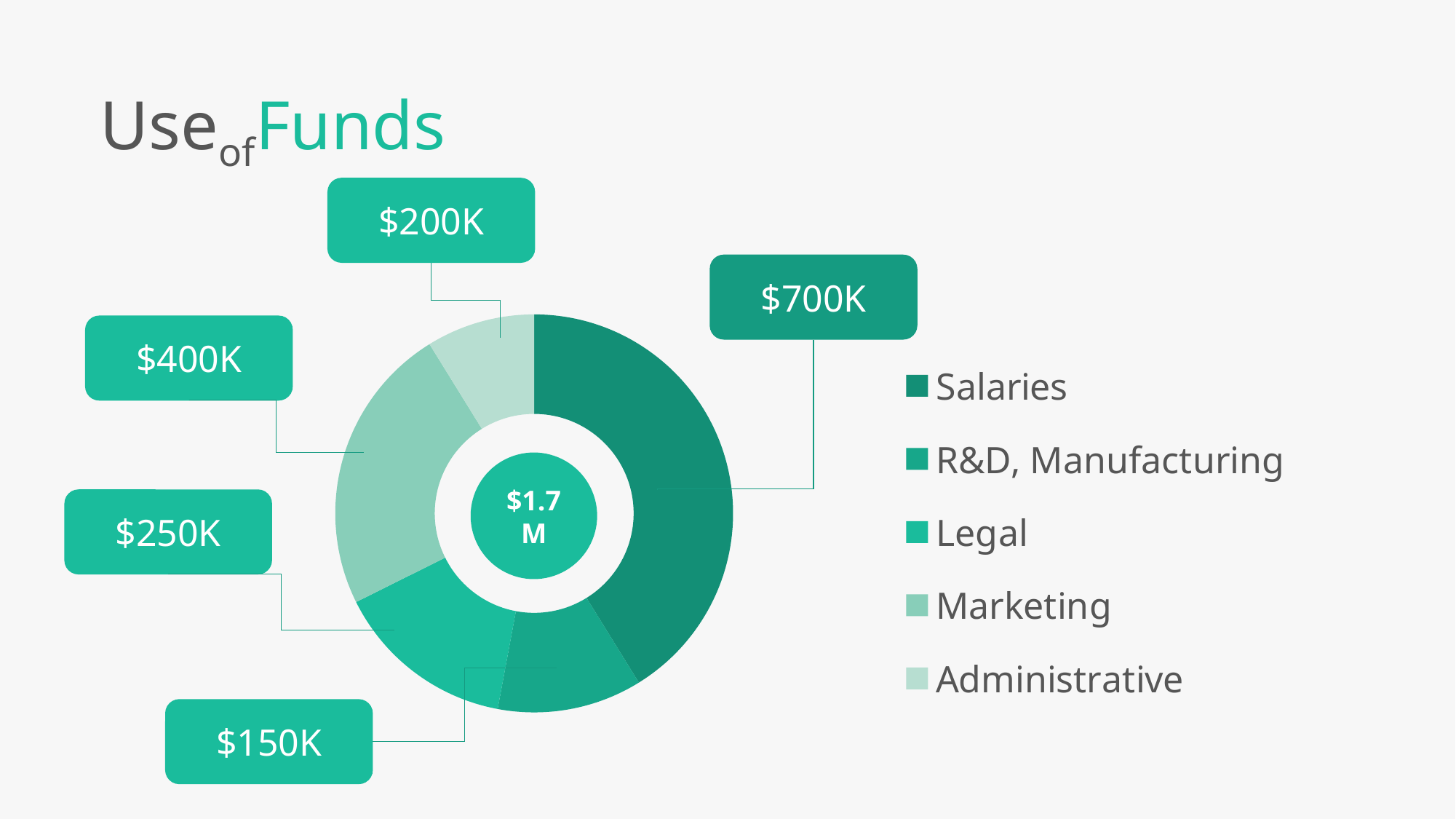
What value is shown for Salaries? $700K Which category receives the largest amount of funds? Salaries What kind of chart is shown on the slide? Pie (donut) chart Which is larger, the amount for Legal or the amount for Administrative? Legal How many categories are shown in the chart? 5 What is the title of the slide? Use of Funds What total amount is shown in the centre of the chart? $1.7 M What is the difference between the Salaries and Marketing amounts? $300K What value is shown for Marketing? $400K Which category receives the smallest amount of funds? Administrative